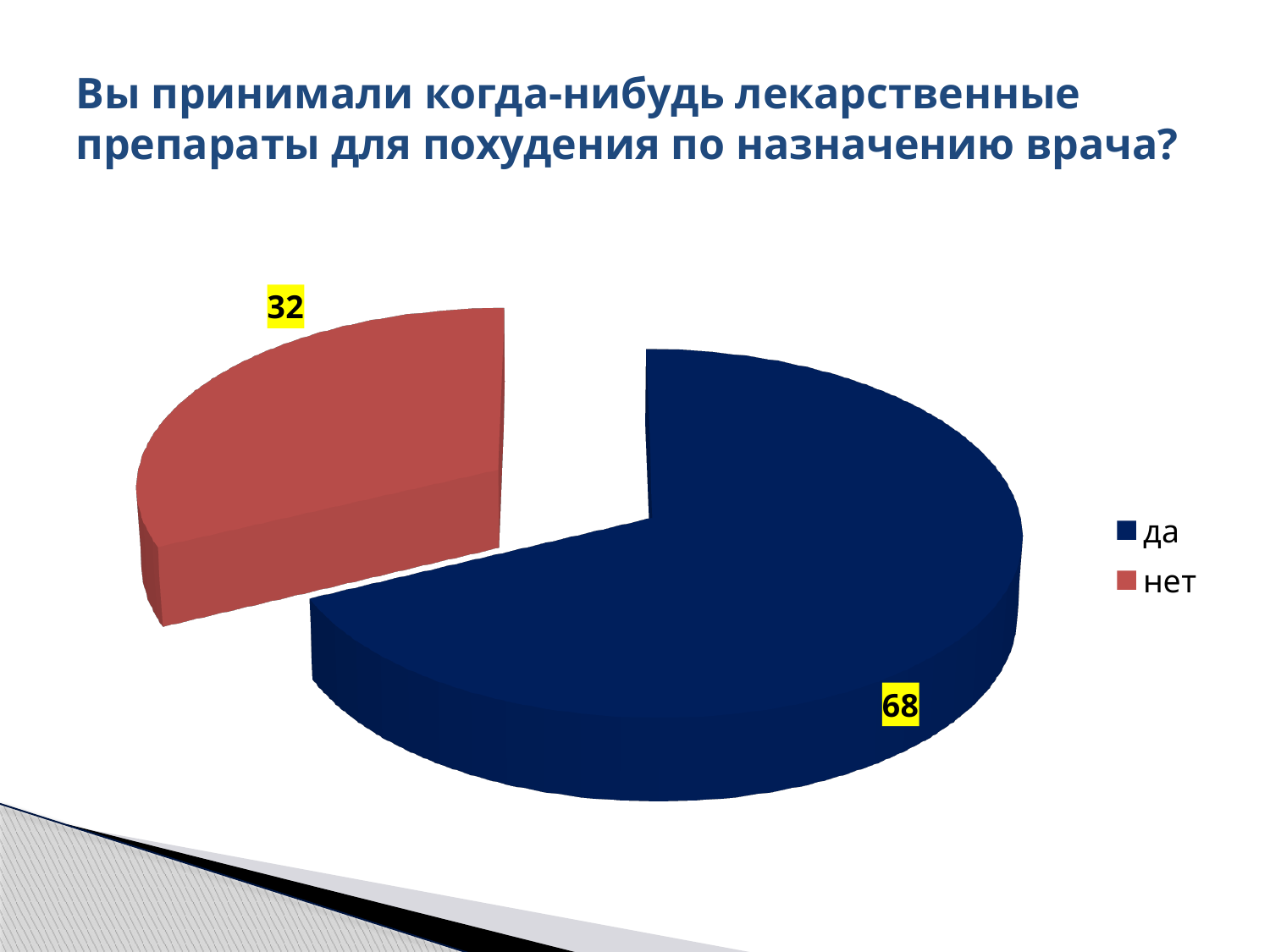
What value is shown for the "нет" slice? 32 What value is shown for the "да" slice? 68 Which category has the smallest slice? нет How many slices does the pie chart have? 2 What kind of chart is shown on the slide? pie chart What is the total of the two slice values? 100 Which is larger, the value for "да" or the value for "нет"? да What colour is the "да" slice? dark blue What share of the pie does the "нет" slice represent? 32% How many entries does the legend list? 2 Which category has the largest slice? да What is the difference between the values for "да" and "нет"? 36